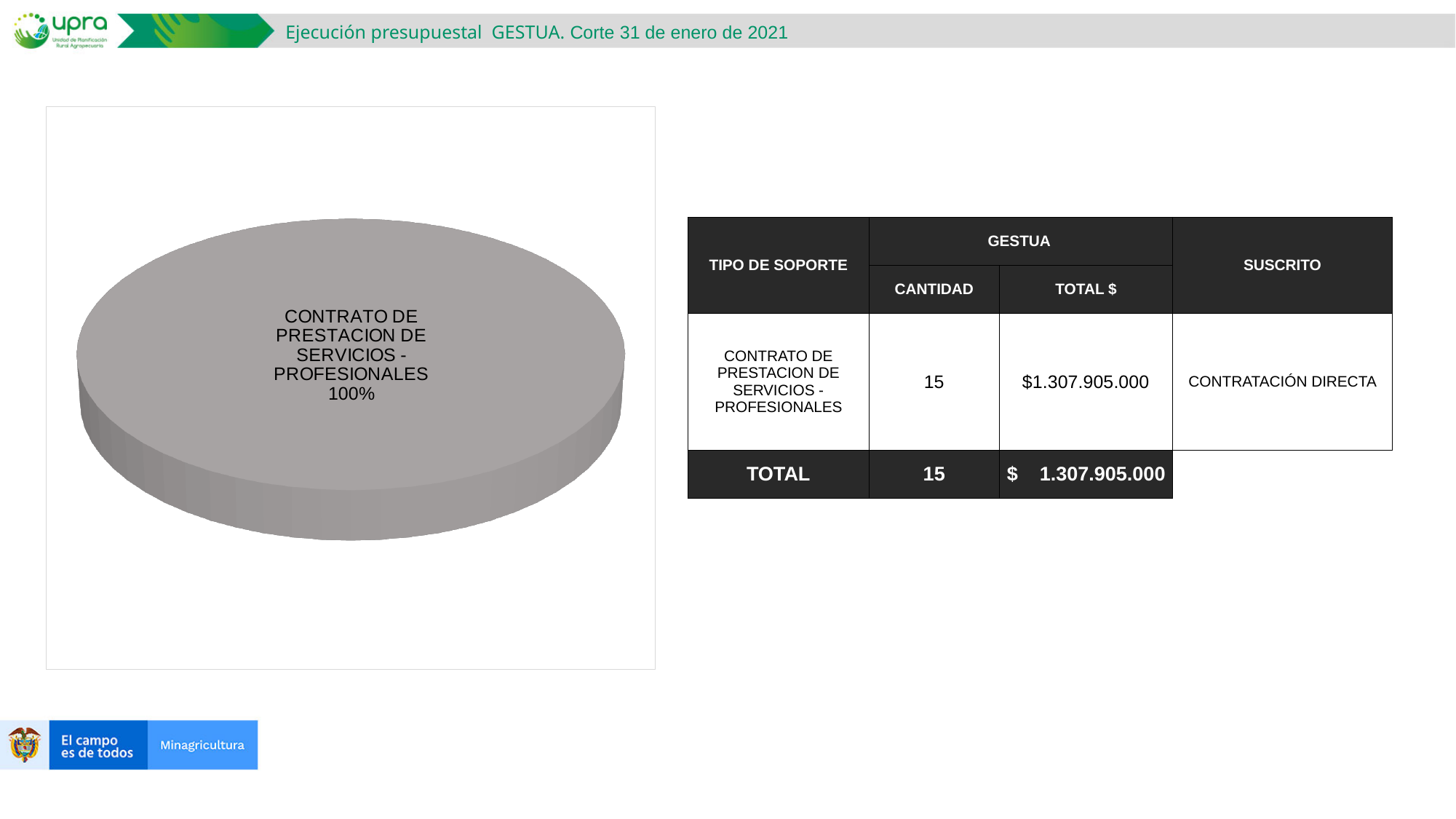
Which category is shown in the pie chart? CONTRATO DE PRESTACION DE SERVICIOS - PROFESIONALES What share of the pie does CONTRATO DE PRESTACION DE SERVICIOS - PROFESIONALES represent? 100% What percentage label is printed on the pie chart slice? 100% What kind of chart is shown on the slide? pie chart How many slices does the pie chart have? 1 Is the pie chart drawn in 3D or flat 2D? 3D